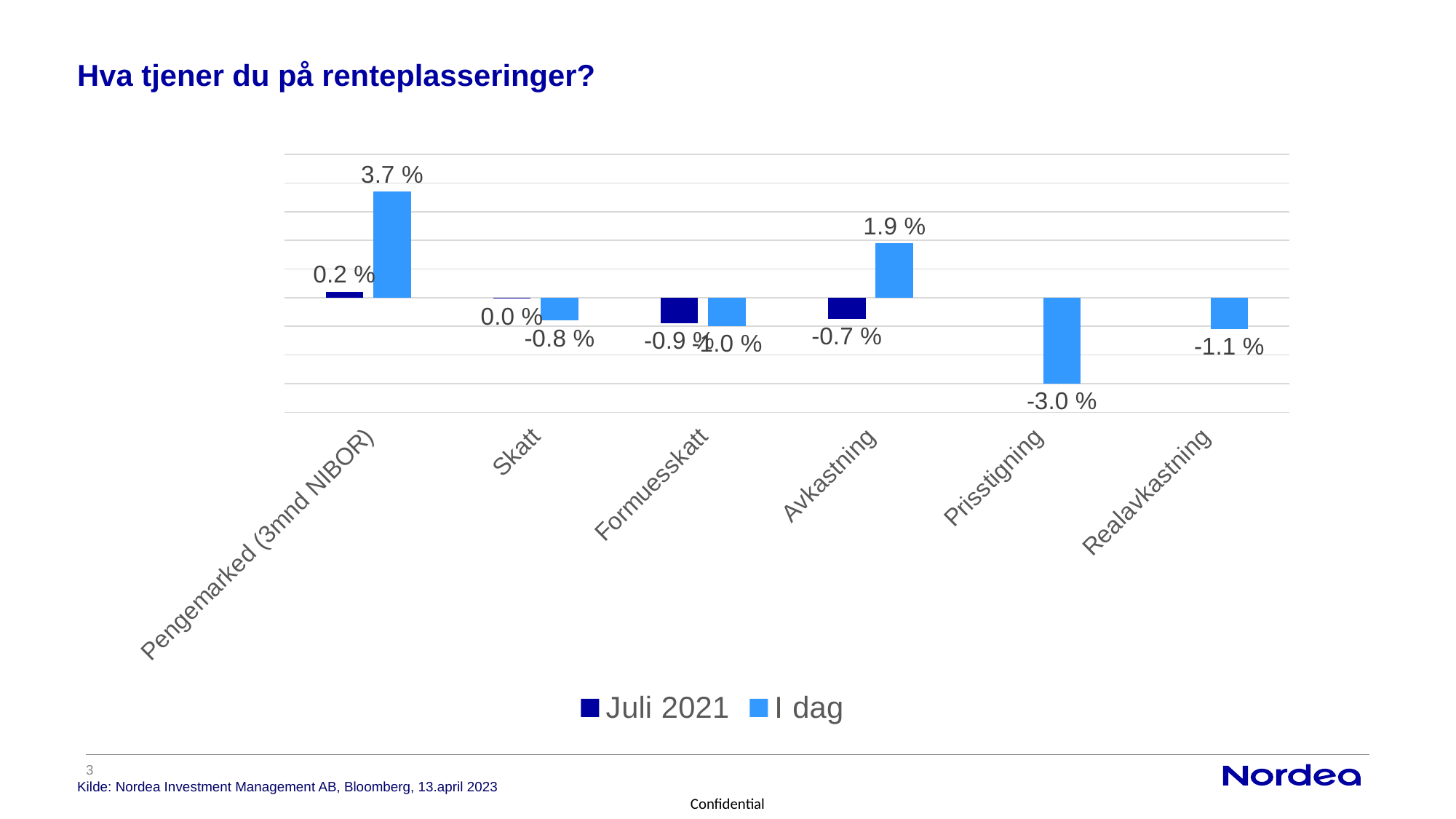
How many categories are shown on the x axis? 6 Which category has the lowest 'I dag' value? Prisstigning How many series does the legend list? 2 For Avkastning, which series has the larger value, 'Juli 2021' or 'I dag'? I dag What kind of chart is shown on the slide? Bar chart Which category has the highest 'I dag' value? Pengemarked (3mnd NIBOR) What is the 'I dag' value for Prisstigning? -3.0 % What is the 'Juli 2021' value for Avkastning? -0.7 % What is the title of the slide? Hva tjener du på renteplasseringer? What is the 'Juli 2021' value for Skatt? 0.0 % What is the difference between the 'I dag' and 'Juli 2021' values for Pengemarked (3mnd NIBOR)? 3.5 % What is the 'I dag' value for Pengemarked (3mnd NIBOR)? 3.7 %